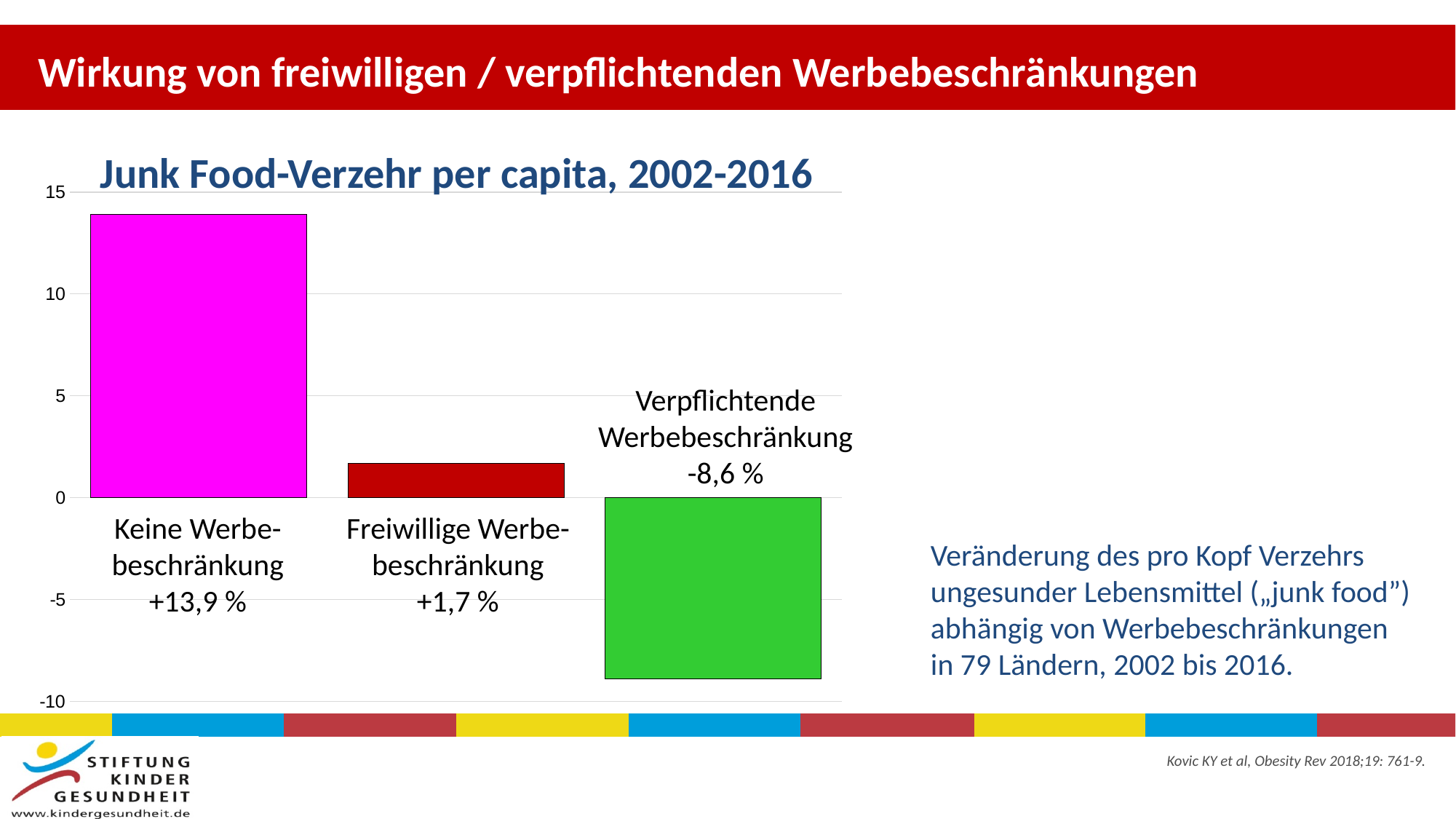
Which category has the highest value? Keine Werbebeschränkung What is the value shown for "Verpflichtende Werbebeschränkung"? -8,6 % How many categories are shown in the chart? 3 Is the value for "Keine Werbebeschränkung" greater or less than 10? greater What is the value shown for "Keine Werbebeschränkung"? +13,9 % Which is larger, the value for "Freiwillige Werbebeschränkung" or for "Verpflichtende Werbebeschränkung"? Freiwillige Werbebeschränkung Which category has the lowest value? Verpflichtende Werbebeschränkung What colour is the bar for "Verpflichtende Werbebeschränkung"? green What is the value shown for "Freiwillige Werbebeschränkung"? +1,7 % What is the difference between the values for "Keine Werbebeschränkung" and "Freiwillige Werbebeschränkung"? 12,2 % What kind of chart is shown on the slide? bar chart What is the title of the chart? Junk Food-Verzehr per capita, 2002-2016